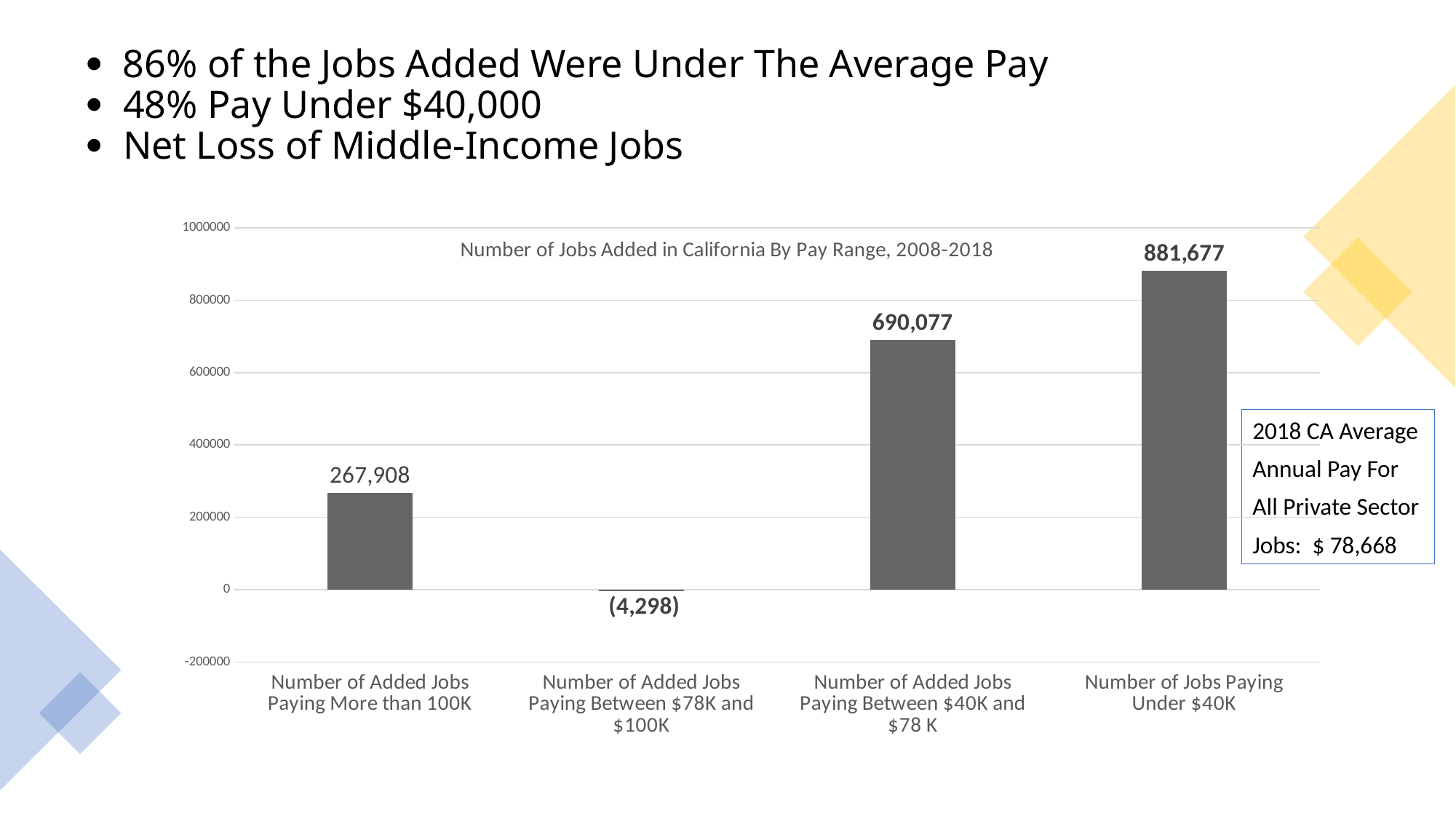
Which category has the lowest value? Number of Added Jobs Paying Between $78K and $100K What is the value for Number of Added Jobs Paying Between $40K and $78 K? 690,077 What is the title of the chart? Number of Jobs Added in California By Pay Range, 2008-2018 Which is larger: the value for Number of Added Jobs Paying More than 100K or the value for Number of Added Jobs Paying Between $40K and $78 K? Number of Added Jobs Paying Between $40K and $78 K What kind of chart is shown on the slide? Bar chart What is the value for Number of Added Jobs Paying Between $78K and $100K? (4,298) How many categories are plotted in the chart? 4 What is the value for Number of Jobs Paying Under $40K? 881,677 What is the difference between the value for Number of Jobs Paying Under $40K and the value for Number of Added Jobs Paying Between $40K and $78 K? 191,600 Which category has the highest value? Number of Jobs Paying Under $40K Is the value for Number of Added Jobs Paying More than 100K greater or less than 400000? less What is the value for Number of Added Jobs Paying More than 100K? 267,908